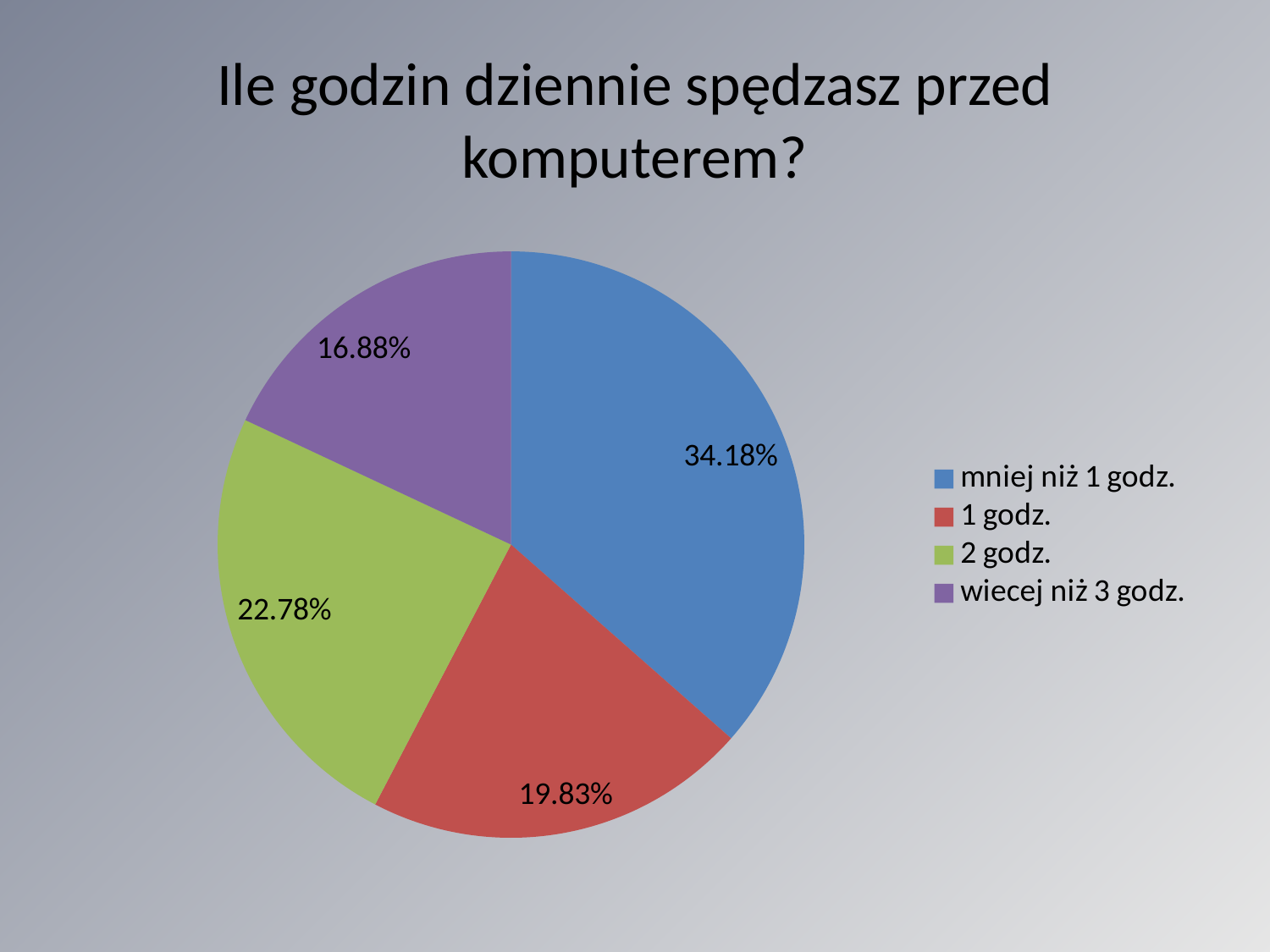
What colour is the slice for "2 godz."? green What is the value shown for "1 godz."? 19.83% What is the difference in percentage points between the "mniej niż 1 godz." slice and the "wiecej niż 3 godz." slice? 17.30 What kind of chart is shown on the slide? pie chart How many categories does the pie chart show? 4 Which is larger, the slice for "2 godz." or the slice for "1 godz."? 2 godz. What is the value shown for "2 godz."? 22.78% What share of the pie does the "mniej niż 1 godz." slice have? 34.18% Which category has the smallest slice of the pie? wiecej niż 3 godz. Which category has the largest slice of the pie? mniej niż 1 godz. What is the value shown for "wiecej niż 3 godz."? 16.88% What is the title of the chart? Ile godzin dziennie spędzasz przed komputerem?